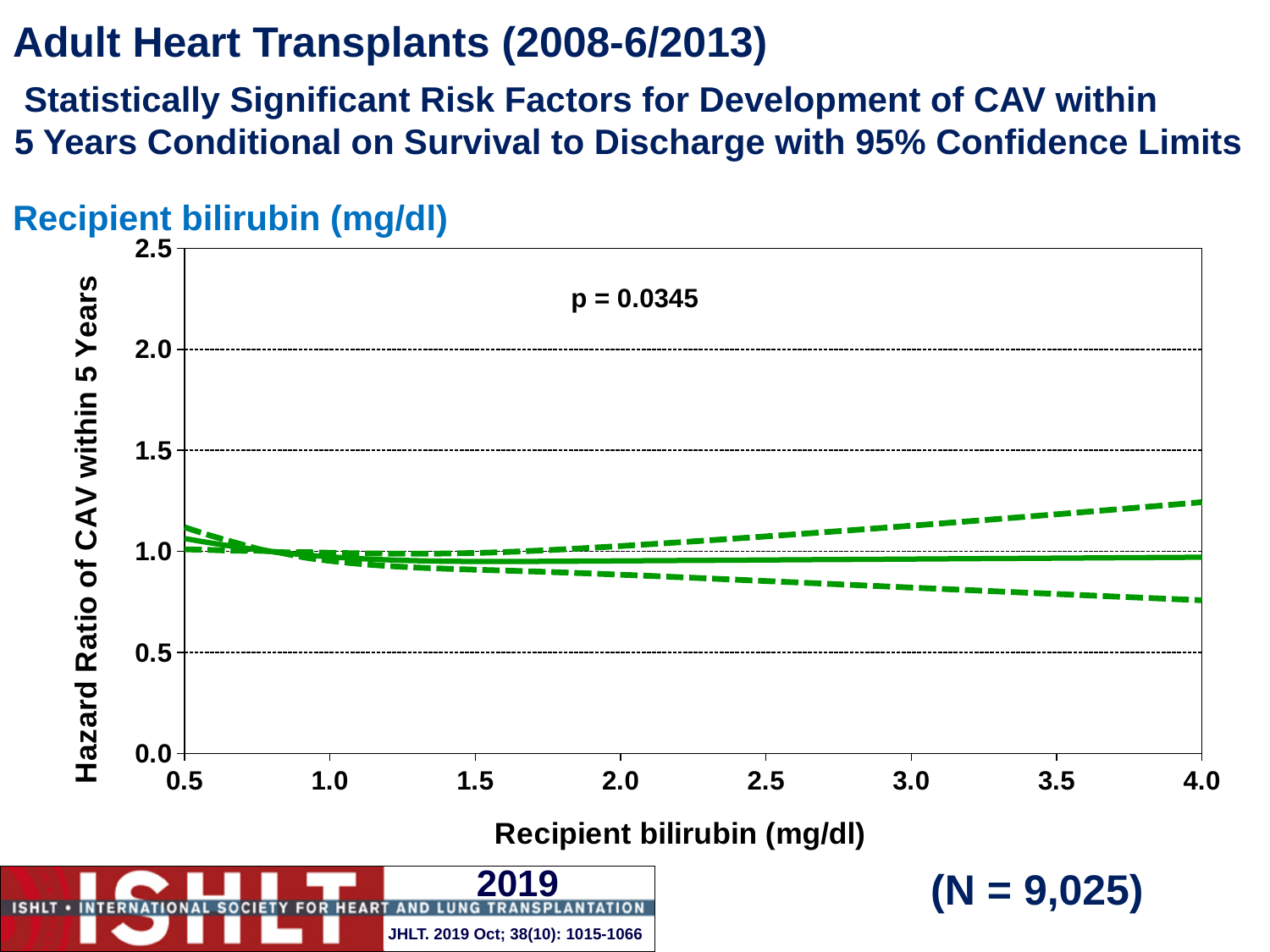
What is the p-value printed on the chart? p = 0.0345 Is the lower dashed confidence limit at a recipient bilirubin of 4.0 mg/dl greater or less than 1.0? less How many tick labels are shown on the x axis? 8 Is the upper dashed confidence limit at a recipient bilirubin of 4.0 mg/dl greater or less than 1.5? less At a recipient bilirubin of 4.0 mg/dl, which is larger: the upper dashed confidence limit or the lower dashed confidence limit? upper dashed confidence limit Is the upper dashed confidence limit at a recipient bilirubin of 4.0 mg/dl greater or less than 1.0? greater Does the lower dashed confidence limit rise or fall as recipient bilirubin increases from 1.0 to 4.0 mg/dl? fall What kind of chart is shown on the slide? line chart Does the upper dashed confidence limit rise or fall as recipient bilirubin increases from 1.0 to 4.0 mg/dl? rise What is the sample size (N) shown on the slide? N = 9,025